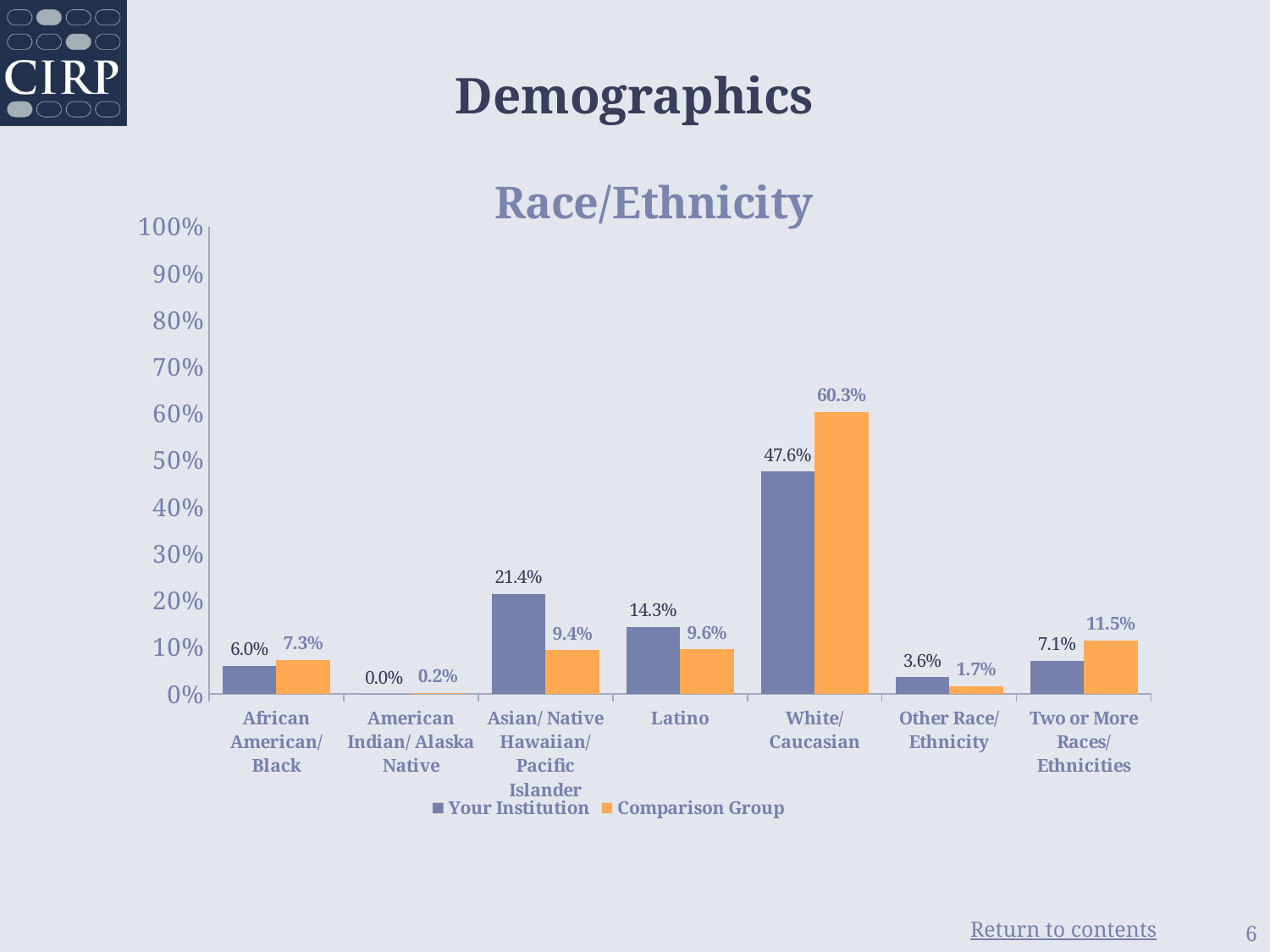
Which category has the highest Comparison Group value? White/Caucasian What is the Comparison Group value for Two or More Races/Ethnicities? 11.5% What is the difference between the Comparison Group and Your Institution values for White/Caucasian? 12.7% Is the Your Institution value for White/Caucasian greater or less than 50%? less What is the Your Institution value for Asian/Native Hawaiian/Pacific Islander? 21.4% What is the difference between the Your Institution and Comparison Group values for Asian/Native Hawaiian/Pacific Islander? 12.0% How many series does the legend list? 2 Which category has the lowest Your Institution value? American Indian/Alaska Native Which is larger for Latino: Your Institution or Comparison Group? Your Institution How many race/ethnicity categories are shown on the x axis? 7 What kind of chart is shown on the slide? bar chart What is the Your Institution value for White/Caucasian? 47.6%